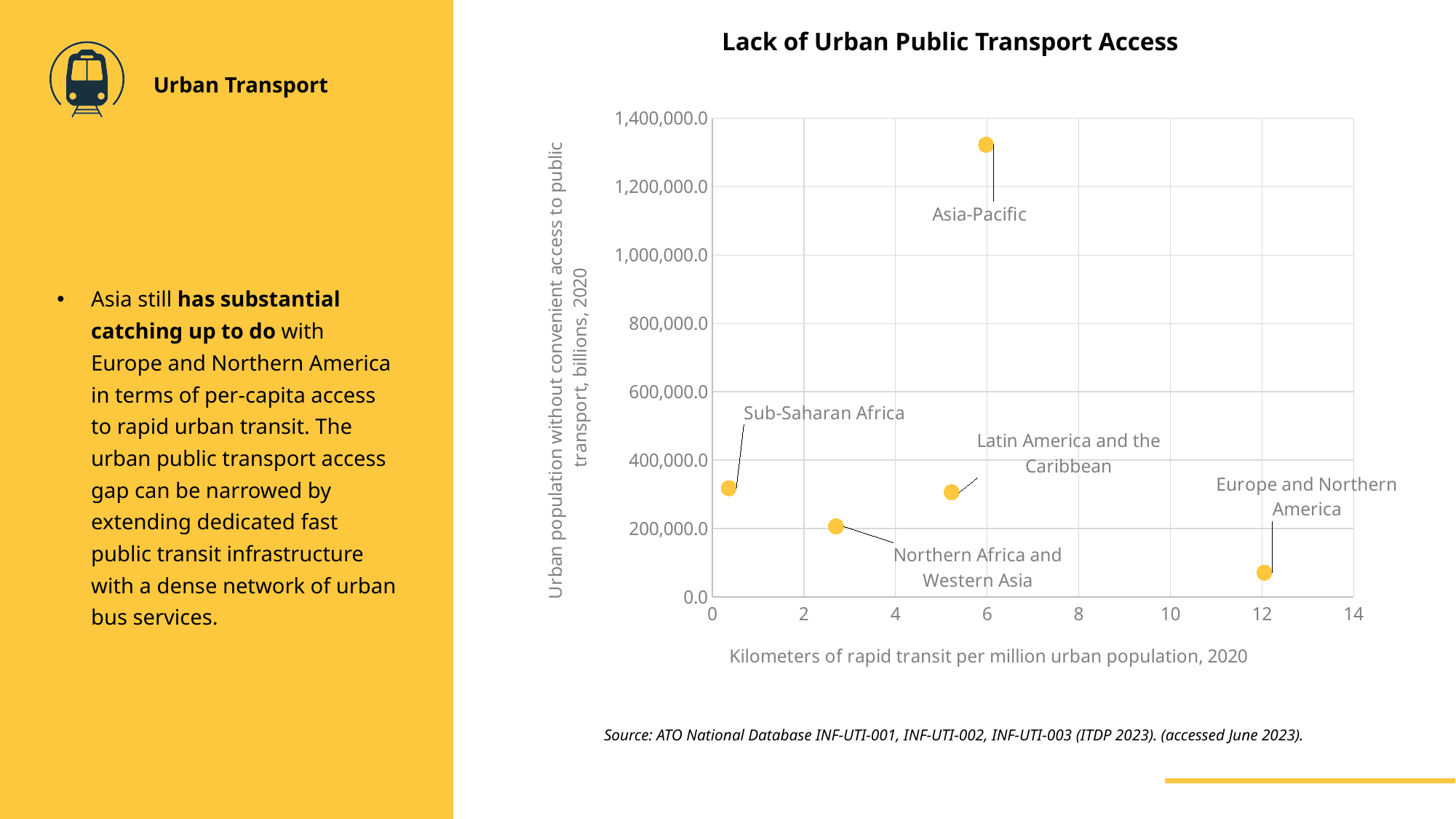
How many regions are plotted on the chart? 5 Which region has the highest kilometers of rapid transit per million urban population? Europe and Northern America Which region has the highest urban population without convenient access to public transport? Asia-Pacific Is the kilometers of rapid transit per million urban population for Europe and Northern America greater or less than 10? greater What is the title of the chart? Lack of Urban Public Transport Access Is the urban population without convenient access to public transport for Europe and Northern America greater or less than 200,000.0? less Is the urban population without convenient access to public transport for Asia-Pacific greater or less than 1,200,000.0? greater Which region has the lowest kilometers of rapid transit per million urban population? Sub-Saharan Africa What kind of chart is shown on the slide? scatter chart Which has a larger urban population without convenient access to public transport, Asia-Pacific or Northern Africa and Western Asia? Asia-Pacific Which region has the lowest urban population without convenient access to public transport? Europe and Northern America